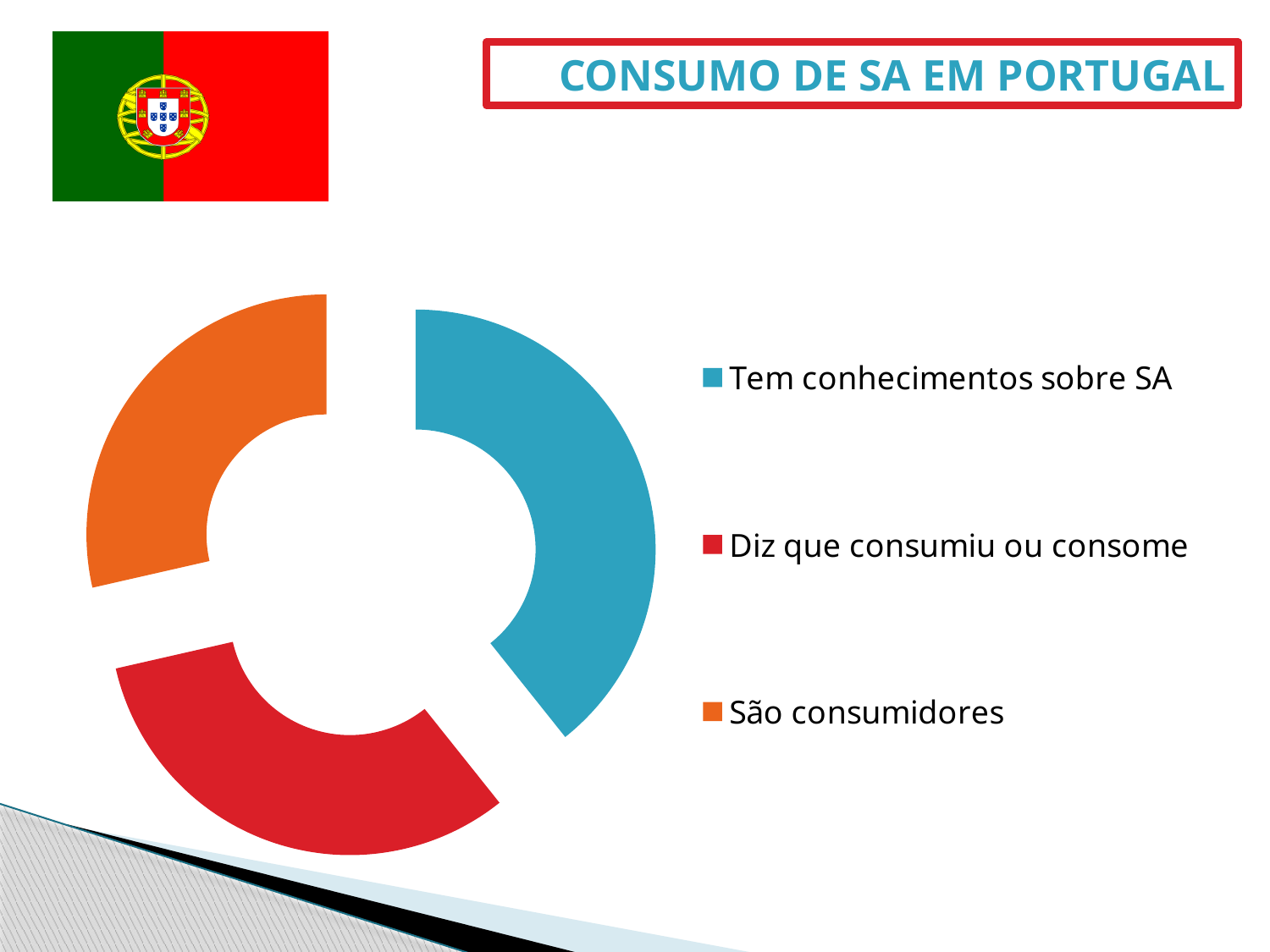
Which category has the largest slice in the chart? Tem conhecimentos sobre SA What kind of chart is shown on the slide? Doughnut (pie) chart What is the title of the slide containing the chart? CONSUMO DE SA EM PORTUGAL How many categories (slices) does the chart have? 3 How many entries does the chart's legend list? 3 Which slice is larger: "Tem conhecimentos sobre SA" or "Diz que consumiu ou consome"? Tem conhecimentos sobre SA Which slice is larger: "Tem conhecimentos sobre SA" or "São consumidores"? Tem conhecimentos sobre SA What colour represents "São consumidores" in the chart? Orange